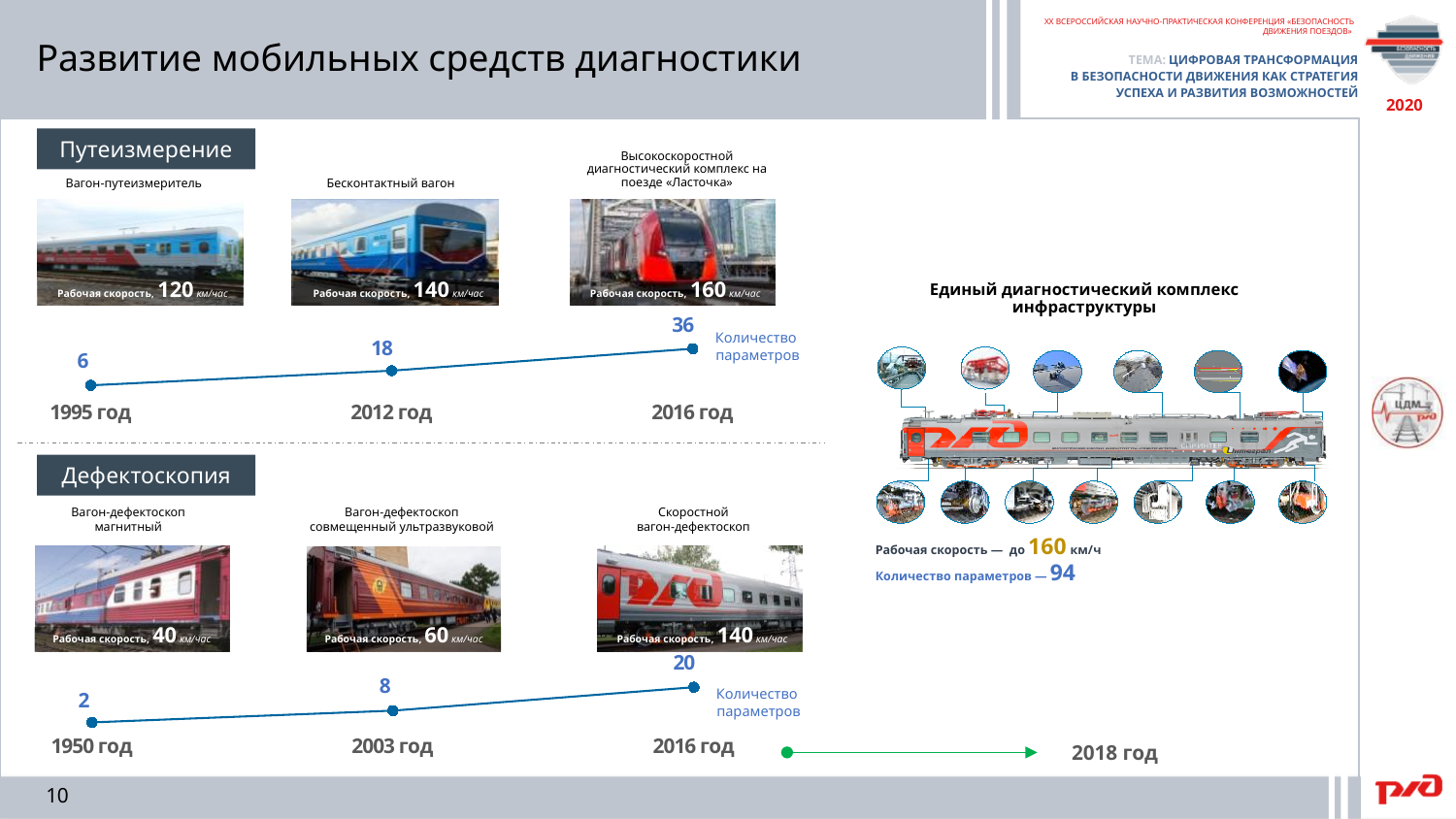
On the Дефектоскопия chart, what is the Количество параметров value for 2003 год? 8 On the Дефектоскопия chart, what is the Количество параметров value for 1950 год? 2 On the Дефектоскопия chart, which year has the lowest Количество параметров? 1950 год On the Дефектоскопия chart, do the values rise or fall from 1950 год to 2016 год? rise On the Путеизмерение chart, what is the Количество параметров value for 2012 год? 18 On the Дефектоскопия chart, what is the Количество параметров value for 2016 год? 20 On the Путеизмерение chart, how many data points are plotted? 3 On the Путеизмерение chart, what is the Количество параметров value for 2016 год? 36 On the Путеизмерение chart, which year has the highest Количество параметров? 2016 год What type of chart is used in the Путеизмерение section to show Количество параметров? line chart On the Путеизмерение chart, what is the Количество параметров value for 1995 год? 6 On the Путеизмерение chart, what is the difference in Количество параметров between 2016 год and 2012 год? 18